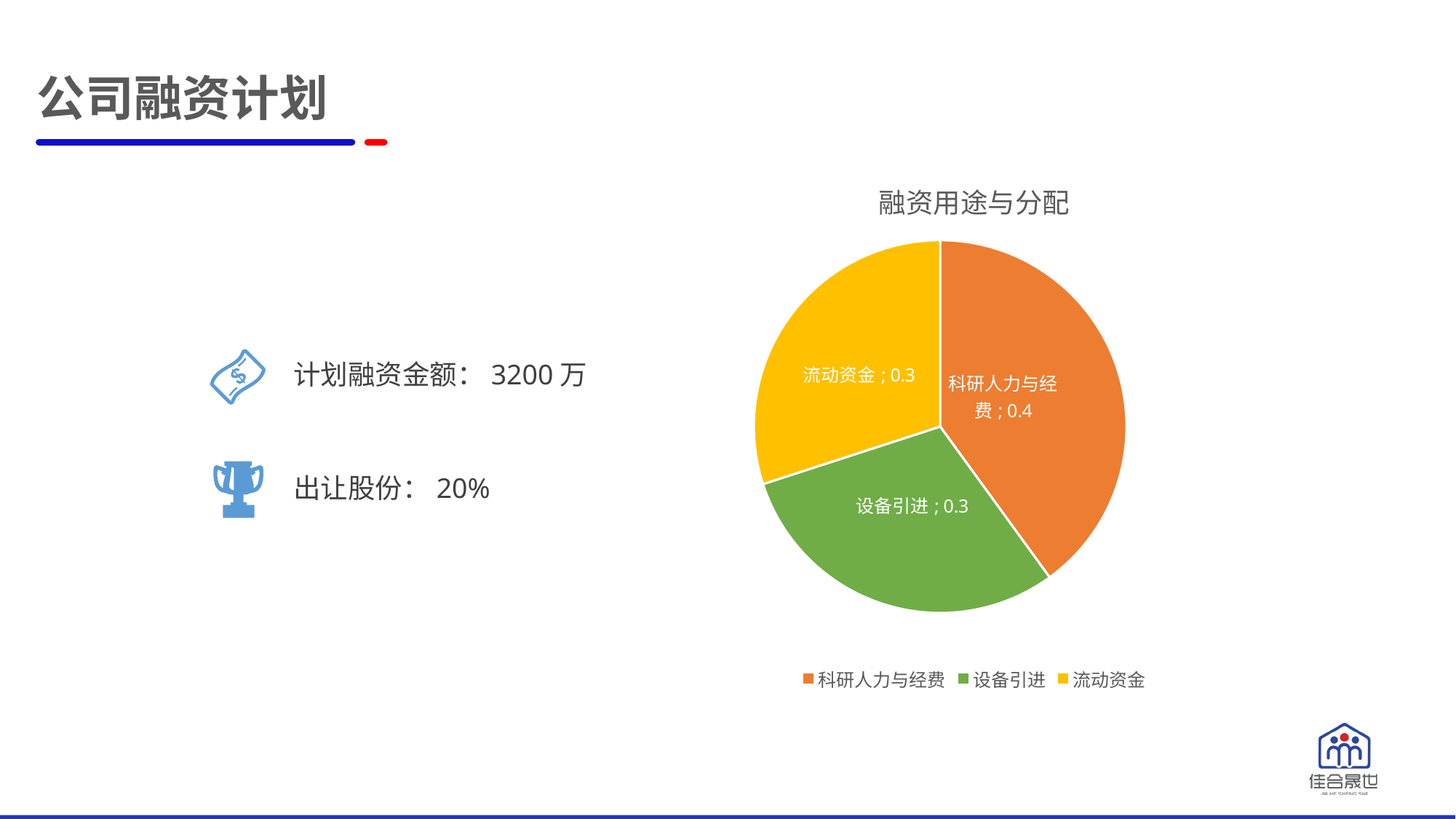
What is the value shown for 流动资金 in the pie chart? 0.3 What is the title of the chart? 融资用途与分配 What share of the pie does 科研人力与经费 represent? 0.4 What is the value shown for 科研人力与经费 in the pie chart? 0.4 How many entries does the chart legend list? 3 What is the difference between the values for 科研人力与经费 and 流动资金? 0.1 What is the value shown for 设备引进 in the pie chart? 0.3 How many slices does the pie chart have? 3 What colour is the 设备引进 slice in the pie chart? Green Which category has the largest slice in the pie chart? 科研人力与经费 What kind of chart is shown on the slide? Pie chart Which is larger, the slice for 科研人力与经费 or the slice for 设备引进? 科研人力与经费